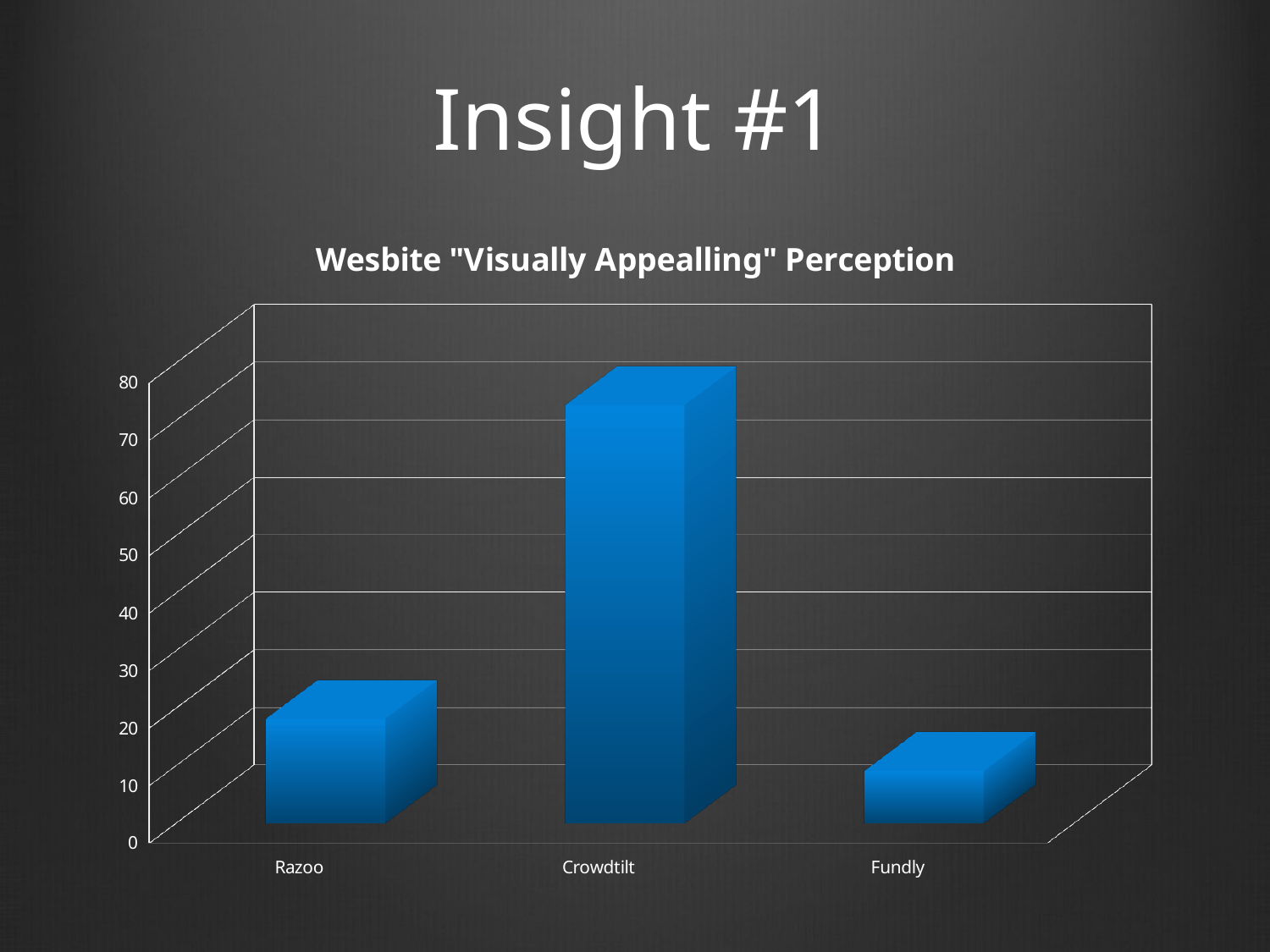
What kind of chart is shown on the slide? Bar chart Is the value for Razoo greater or less than 40? less Which category has the highest value? Crowdtilt Which has a larger value, Razoo or Fundly? Razoo What is the highest value shown on the vertical axis? 80 Which has a larger value, Crowdtilt or Razoo? Crowdtilt Is the value for Fundly greater or less than 30? less Which category has the lowest value? Fundly What is the title of the chart? Wesbite "Visually Appealling" Perception How many categories are plotted on the x axis? 3 Is the value for Crowdtilt greater or less than 60? greater